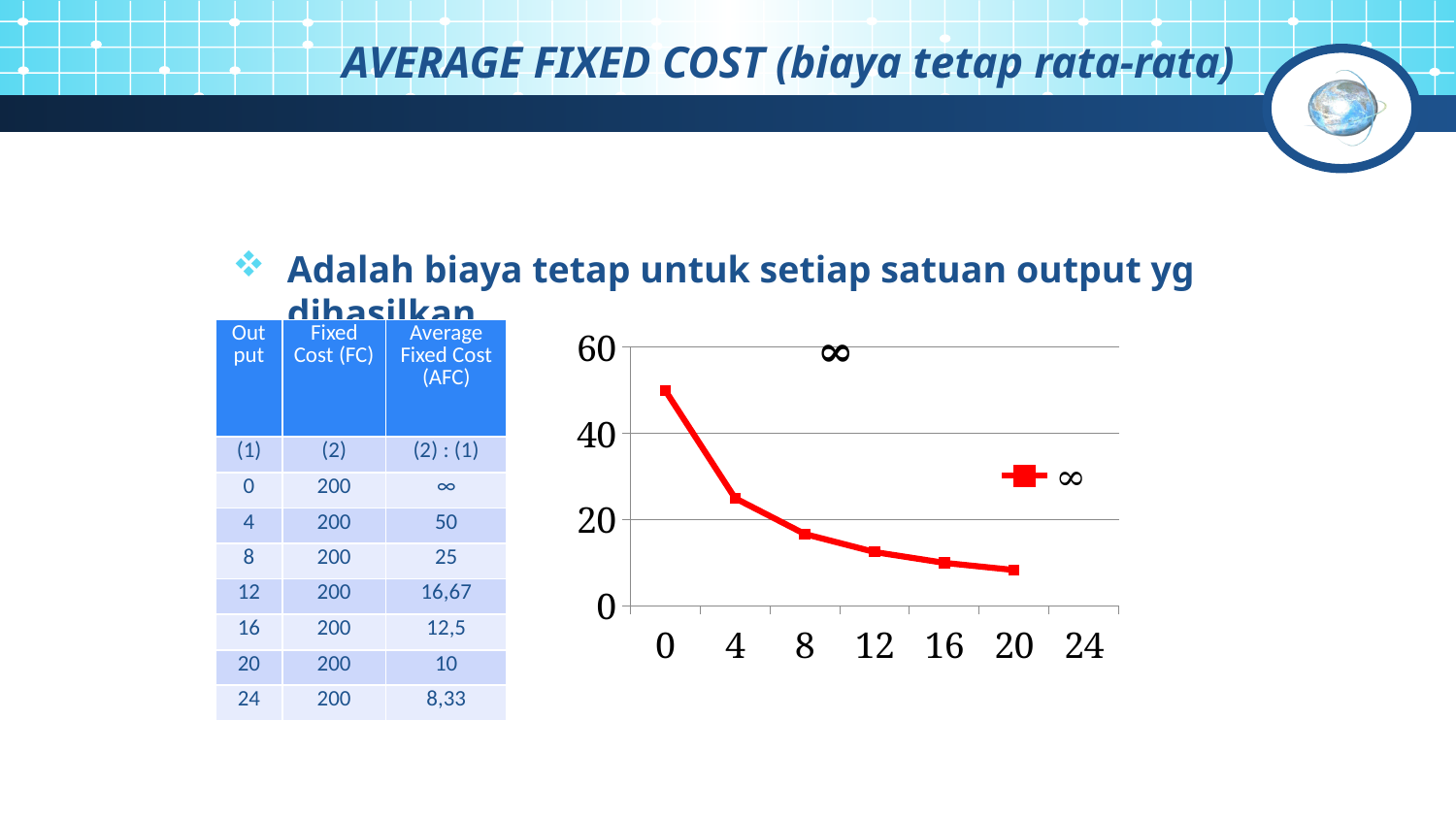
Is the plotted value at x = 8 greater or less than 20? less How many series does the chart legend list? 1 At which x-axis label is the plotted value lowest? 20 Is the plotted value at x = 0 greater or less than 40? greater What colour is the plotted line in the chart? red What kind of chart is shown on the slide? line chart What is the title shown above the chart? ∞ Which has the larger plotted value, x = 4 or x = 12? x = 4 At which x-axis label is the plotted value highest? 0 How many data points are plotted on the line in the chart? 6 Is the plotted value at x = 4 greater or less than 40? less Do the plotted values rise or fall as you move from left to right along the x axis? fall